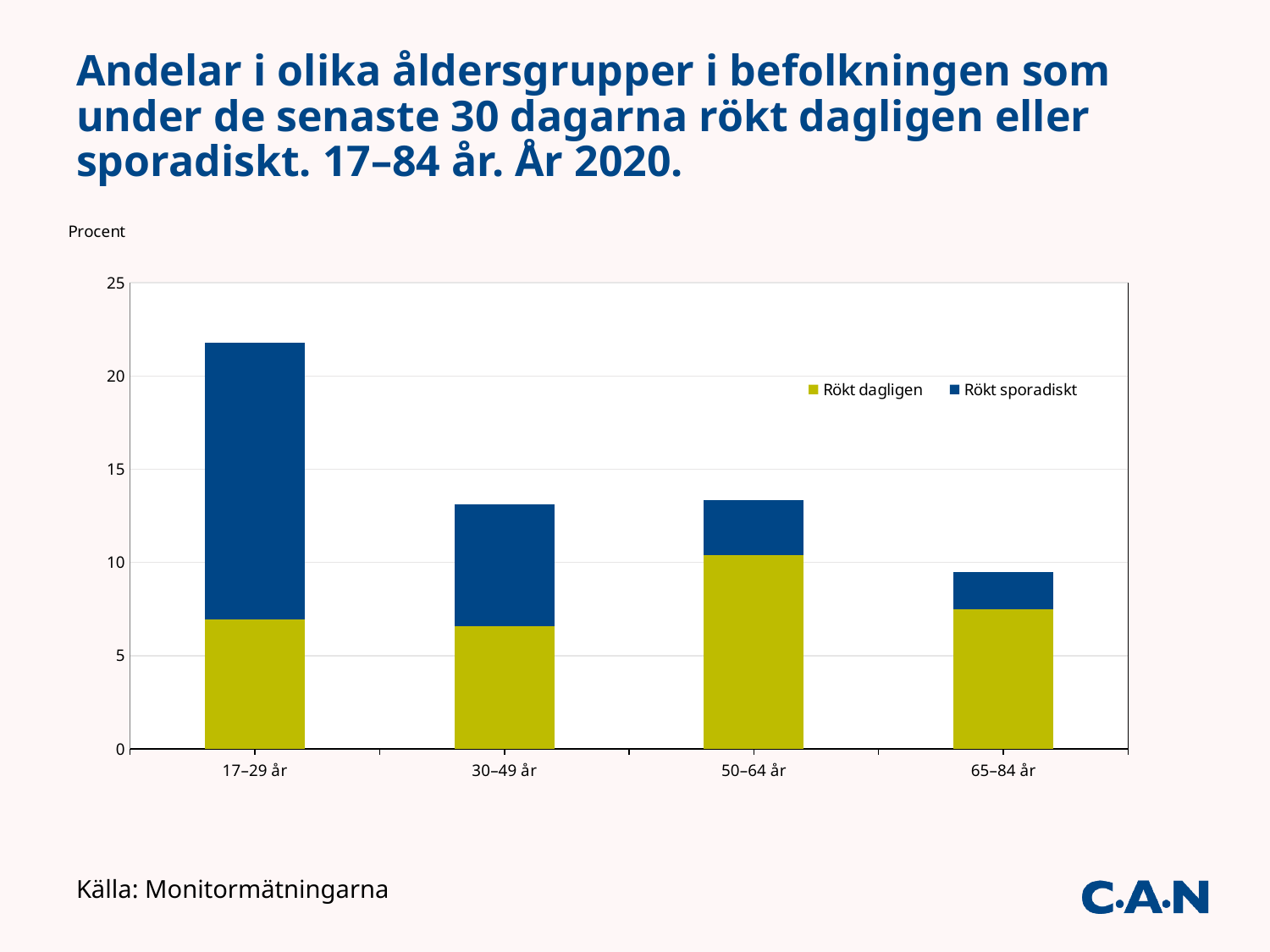
Is the 'Rökt dagligen' value for 30–49 år greater or less than 10? less How many series does the legend list? 2 Is the 'Rökt dagligen' value for 17–29 år greater or less than 5? greater Which is larger: the total bar for 17–29 år or the total bar for 30–49 år? 17–29 år Is the total bar height for 65–84 år greater or less than 10? less Which age group has the highest share for 'Rökt dagligen'? 50–64 år Which age group has the lowest total share (daily plus sporadic smoking)? 65–84 år How many age groups are shown on the x axis? 4 Which age group has the highest total share (daily plus sporadic smoking)? 17–29 år What kind of chart is shown on the slide? Stacked bar chart What unit is shown on the y axis label? Procent